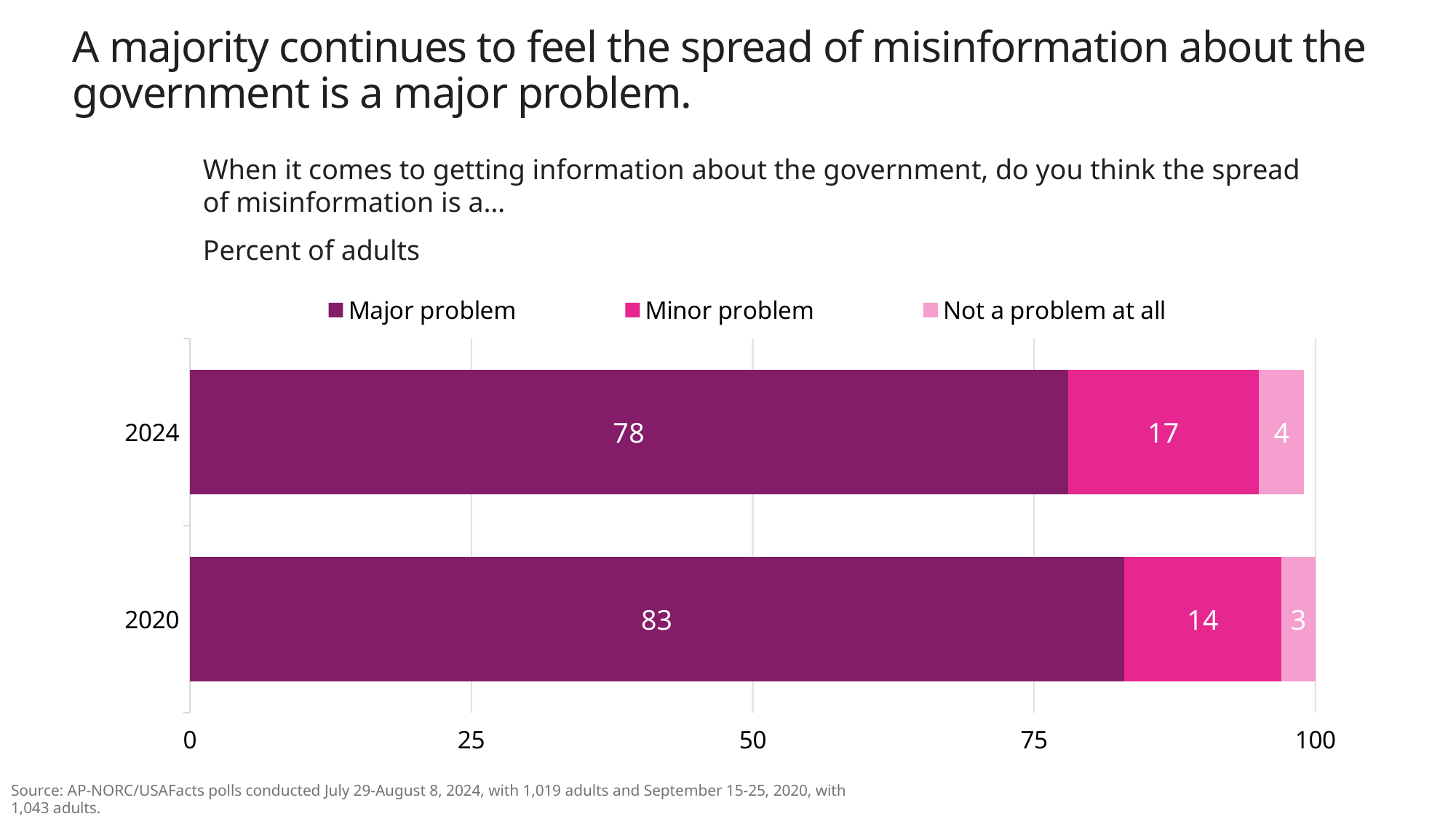
What percent of adults said the spread of misinformation is a major problem in 2024? 78 What percent of adults said the spread of misinformation is a minor problem in 2020? 14 What percent of adults said misinformation is not a problem at all in 2024? 4 What kind of chart is shown on the slide? Stacked bar chart What is the total of the three segments in the 2024 bar? 99 In which year was the share saying 'Major problem' higher, 2020 or 2024? 2020 How many years are shown on the chart? 2 What is the difference between the 'Minor problem' values for 2024 and 2020? 3 What is the total of the three segments in the 2020 bar? 100 How many series does the legend list? 3 Is the 'Major problem' value for 2024 greater or less than 75? greater By how many percentage points did the 'Major problem' share fall from 2020 to 2024? 5